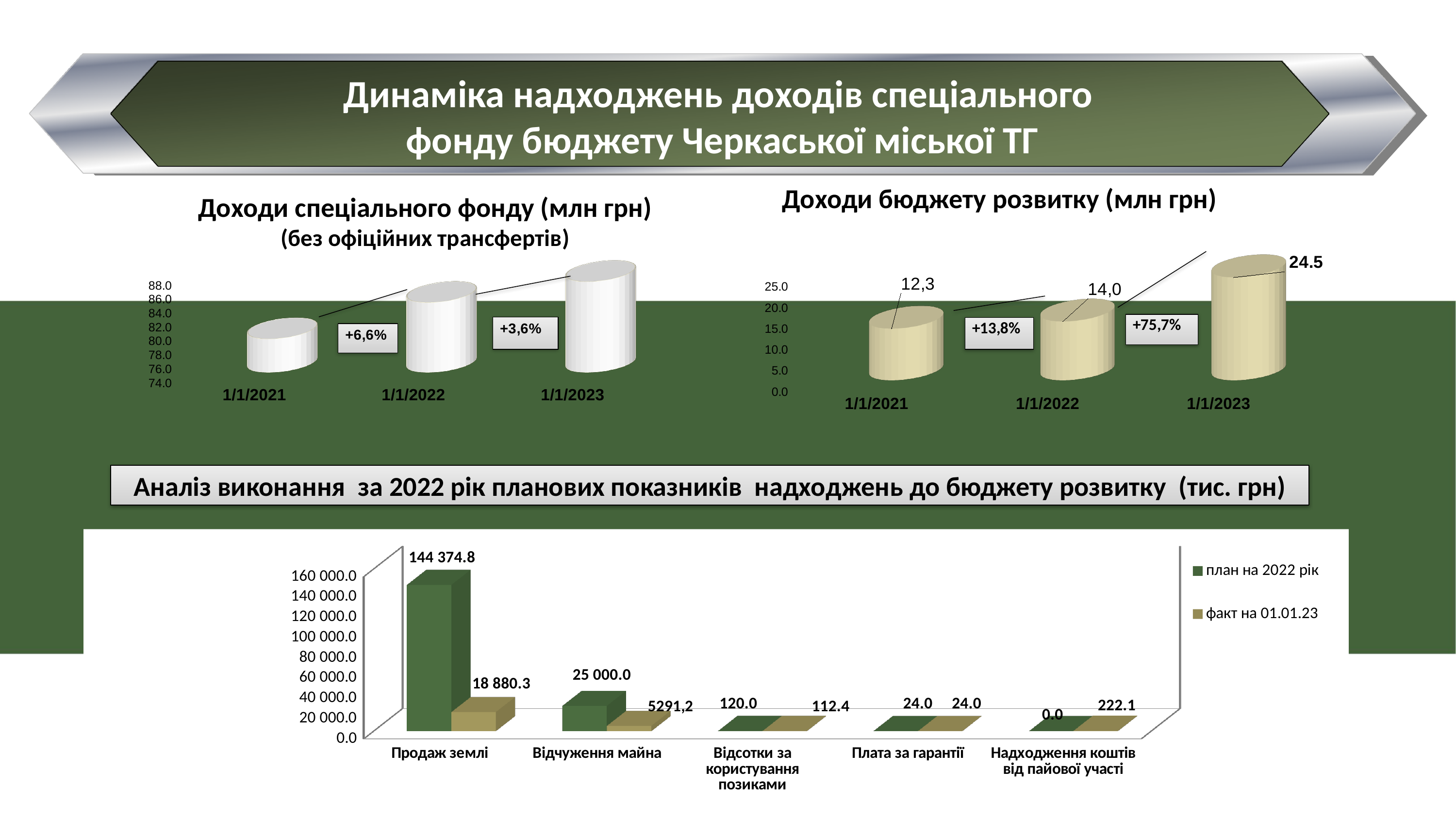
In the chart 'Доходи бюджету розвитку (млн грн)', what is the value for 1/1/2021? 12,3 In the bottom chart 'Аналіз виконання за 2022 рік', what is the 'факт на 01.01.23' value for 'Відчуження майна'? 5291,2 In the chart 'Доходи бюджету розвитку (млн грн)', which date has the highest value? 1/1/2023 In the bottom chart 'Аналіз виконання за 2022 рік', what is the 'план на 2022 рік' value for 'Продаж землі'? 144 374.8 What kind of chart is the bottom chart 'Аналіз виконання за 2022 рік'? bar chart In the chart 'Доходи бюджету розвитку (млн грн)', what is the value for 1/1/2023? 24.5 In the bottom chart 'Аналіз виконання за 2022 рік', which is larger for 'Надходження коштів від пайової участі': the plan or the fact value? факт на 01.01.23 In the bottom chart 'Аналіз виконання за 2022 рік', how many categories are shown on the x axis? 5 In the bottom chart 'Аналіз виконання за 2022 рік', how many series does the legend list? 2 In the chart 'Доходи бюджету розвитку (млн грн)', what percentage change is shown between 1/1/2022 and 1/1/2023? +75,7% In the chart 'Доходи спеціального фонду (млн грн)', is the value for 1/1/2021 greater or less than 84.0? less In the chart 'Доходи спеціального фонду (млн грн)', do the values rise or fall from 1/1/2021 to 1/1/2023? rise